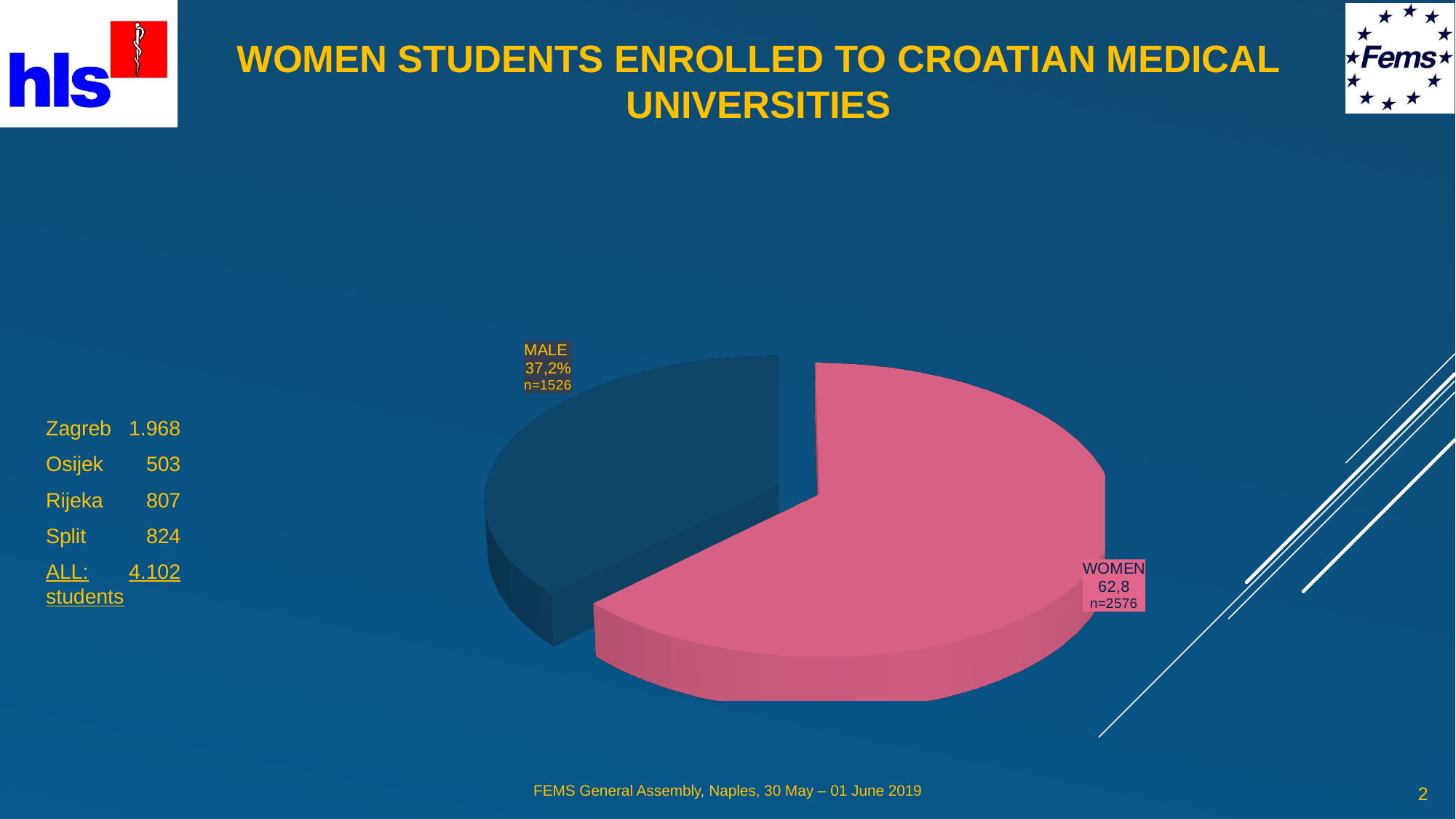
Which slice has the larger n value, MALE or WOMEN? WOMEN Which slice of the pie chart is the largest? WOMEN How many slices does the pie chart have? 2 Which slice of the pie chart is the smallest? MALE What share of the pie is labelled for WOMEN? 62,8 What kind of chart is shown on the slide? pie chart What is the difference between the n values of the WOMEN and MALE slices? 1050 What is the total of the n values of the two slices? 4102 What is the n value shown for the MALE slice? n=1526 What colour is the WOMEN slice of the pie chart? pink What is the n value shown for the WOMEN slice? n=2576 What percentage of the pie is labelled for MALE? 37,2%